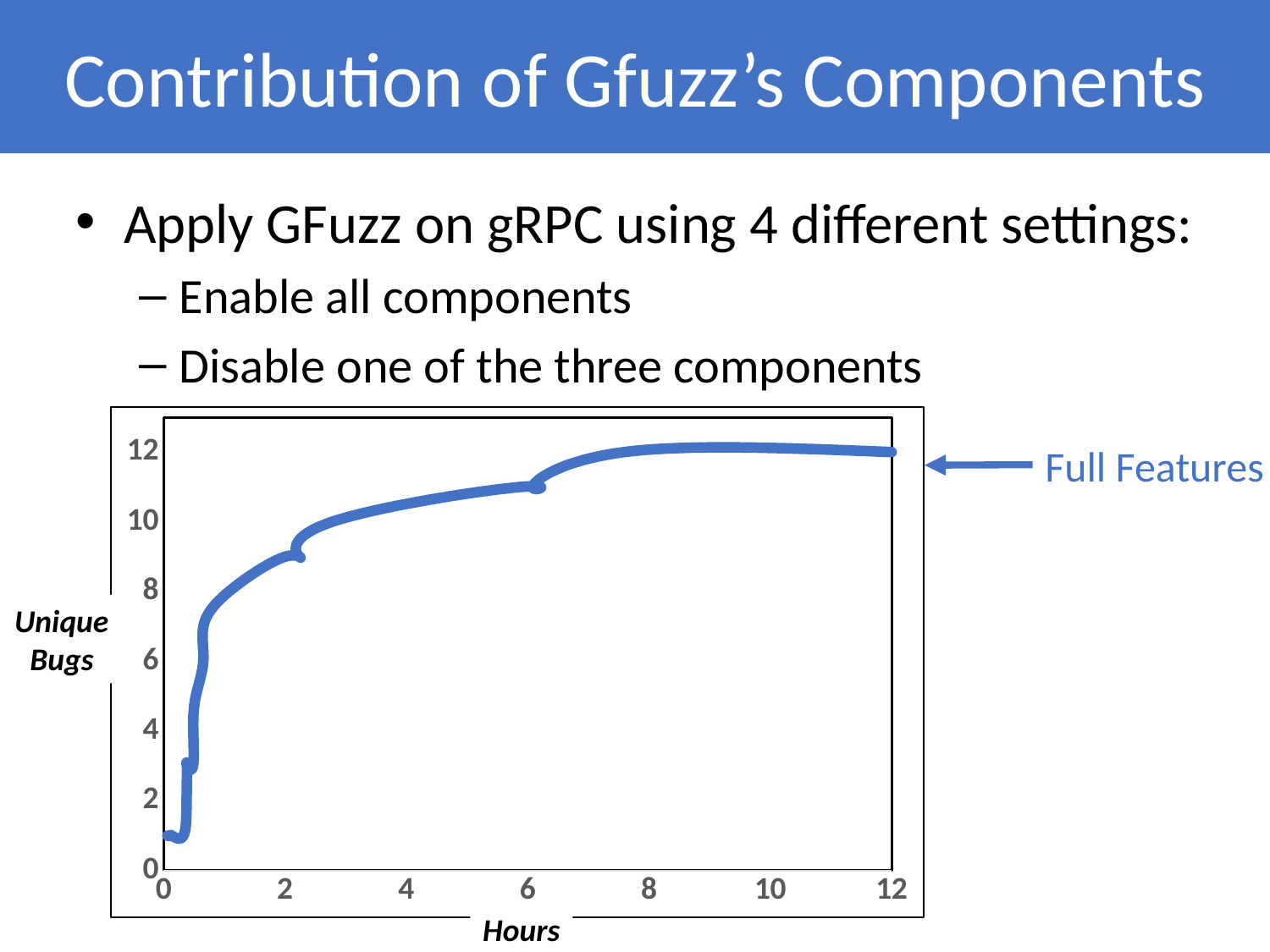
Is the number of unique bugs at 2 hours greater or less than 6? greater Which is larger, the number of unique bugs at 2 hours or at 10 hours? 10 hours Is the number of unique bugs at 12 hours greater or less than 10? greater Is the number of unique bugs at 1 hour greater or less than 4? greater What is the highest value shown on the x axis of the chart? 12 Does the number of unique bugs rise or fall as hours increase from 0 to 8? rise How many data series are plotted in the chart? 1 What kind of chart is shown on the slide? line chart What is the label of the x axis of the chart? Hours What is the label of the y axis of the chart? Unique Bugs